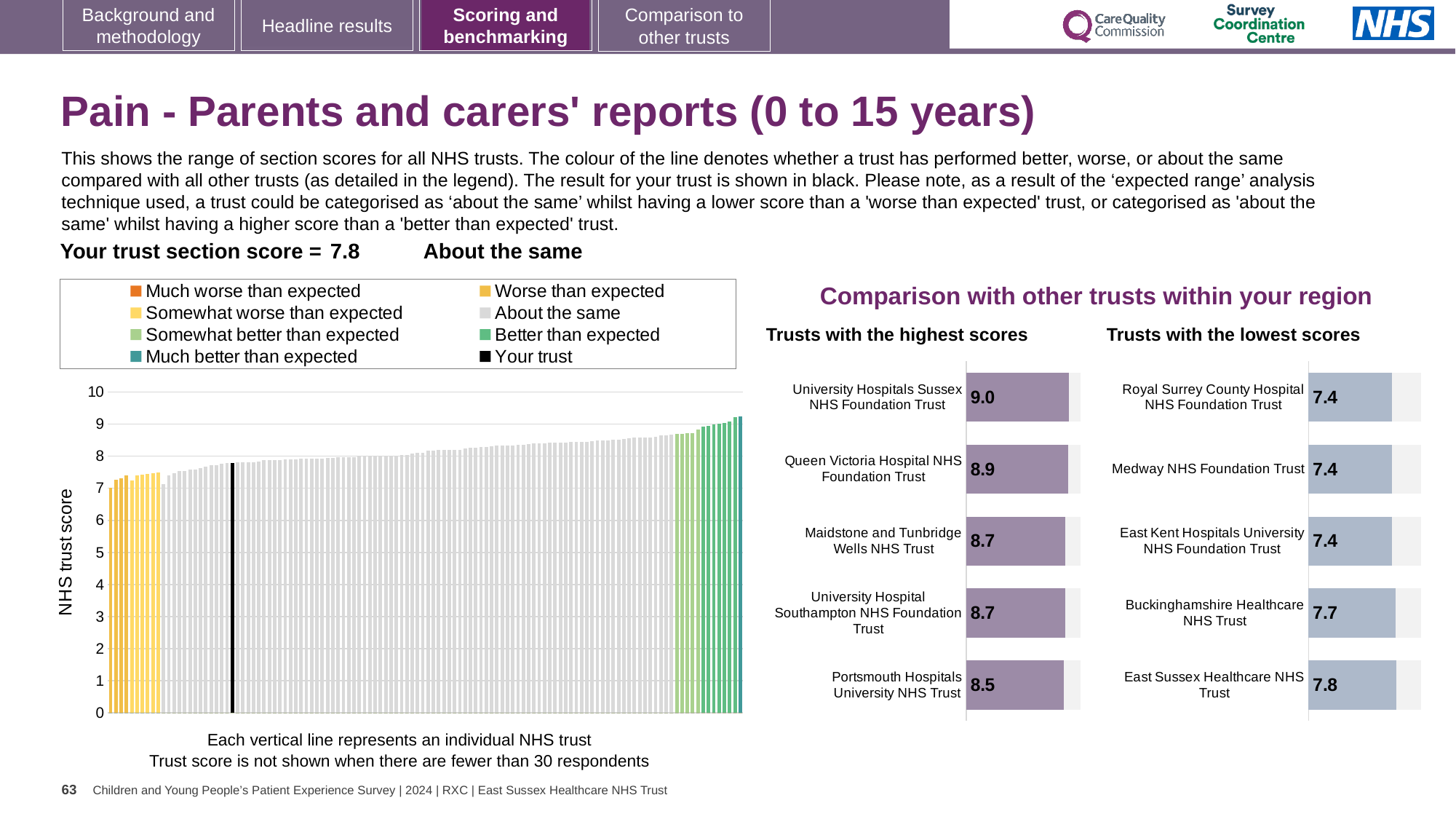
In the 'Trusts with the highest scores' chart, which trust has the highest score? University Hospitals Sussex NHS Foundation Trust How many entries does the legend above the large chart on the left list? 8 In the 'Trusts with the lowest scores' chart, what is the difference between the scores of East Sussex Healthcare NHS Trust and Medway NHS Foundation Trust? 0.4 In the 'Trusts with the highest scores' chart, what is the difference between the scores of University Hospitals Sussex NHS Foundation Trust and Portsmouth Hospitals University NHS Trust? 0.5 What kind of chart is the large chart on the left showing NHS trust scores? bar chart In the 'Trusts with the highest scores' chart, what is the score for Queen Victoria Hospital NHS Foundation Trust? 8.9 In the 'Trusts with the lowest scores' chart, which trust has the highest score? East Sussex Healthcare NHS Trust In the large chart on the left, do the trust scores rise or fall from left to right? rise In the large chart on the left, what is the section score for your trust (the black bar)? 7.8 How many trusts are shown in the 'Trusts with the highest scores' chart? 5 In the 'Trusts with the highest scores' chart, which has the larger score: Queen Victoria Hospital NHS Foundation Trust or Portsmouth Hospitals University NHS Trust? Queen Victoria Hospital NHS Foundation Trust In the 'Trusts with the lowest scores' chart, what is the score for Buckinghamshire Healthcare NHS Trust? 7.7